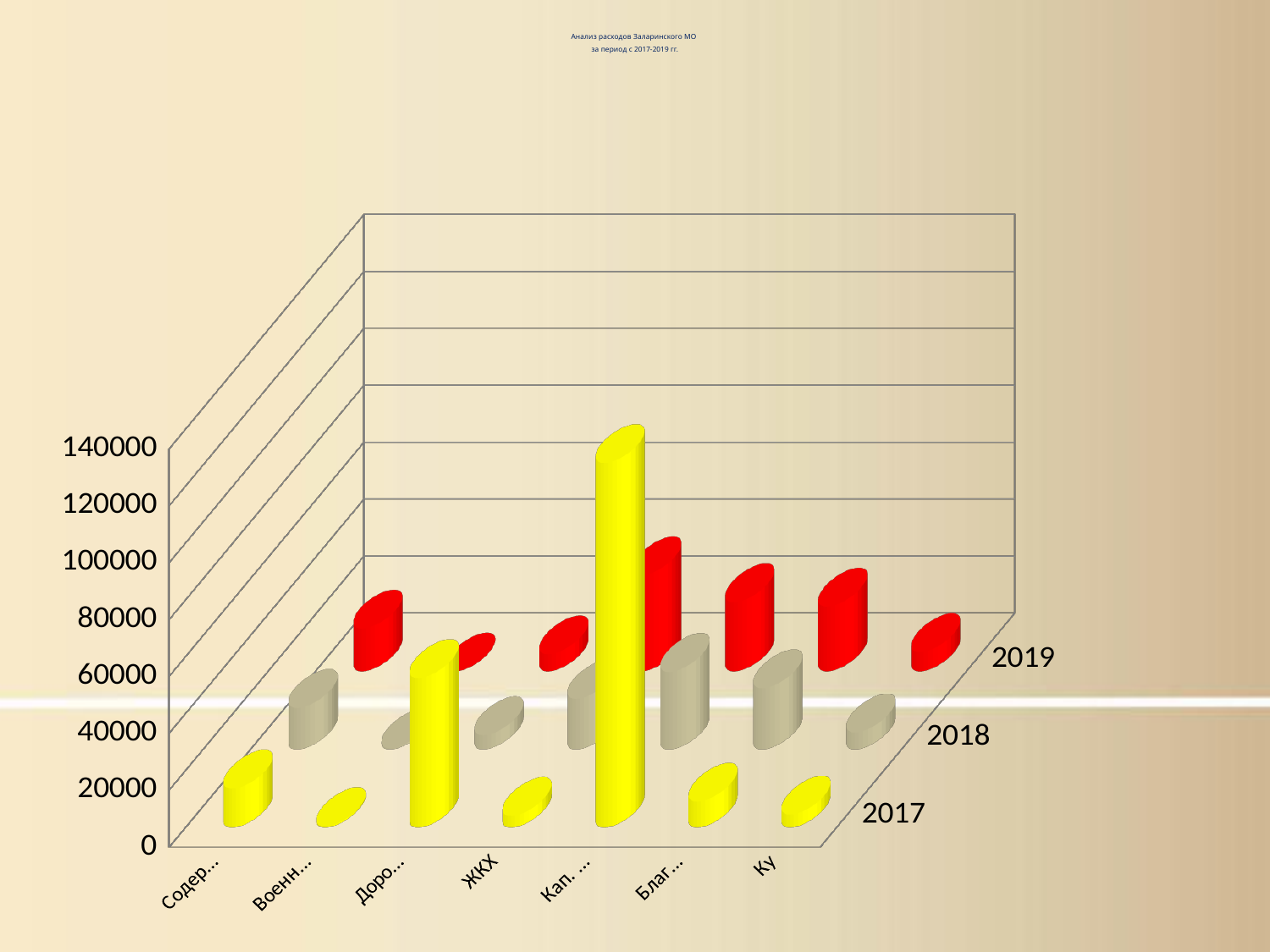
Is the 2017 value for Кап. ... greater or less than 80000? greater What kind of chart is shown on the slide? bar chart How many categories are shown along the x axis of the chart? 7 Which category has the highest value for 2017? Кап. ... What is the highest value shown on the vertical axis? 140000 Which series contains the tallest bar in the chart? 2017 Which years are shown as series in the chart? 2017, 2018, 2019 Which is larger for 2017: the value for Кап. ... or the value for Благ...? Кап. ... What is the title of the chart? Анализ расходов Заларинского МО за период с 2017-2019 гг. Which is larger for 2017: the value for Доро... or the value for Военн...? Доро... How many series (years) does the chart show? 3